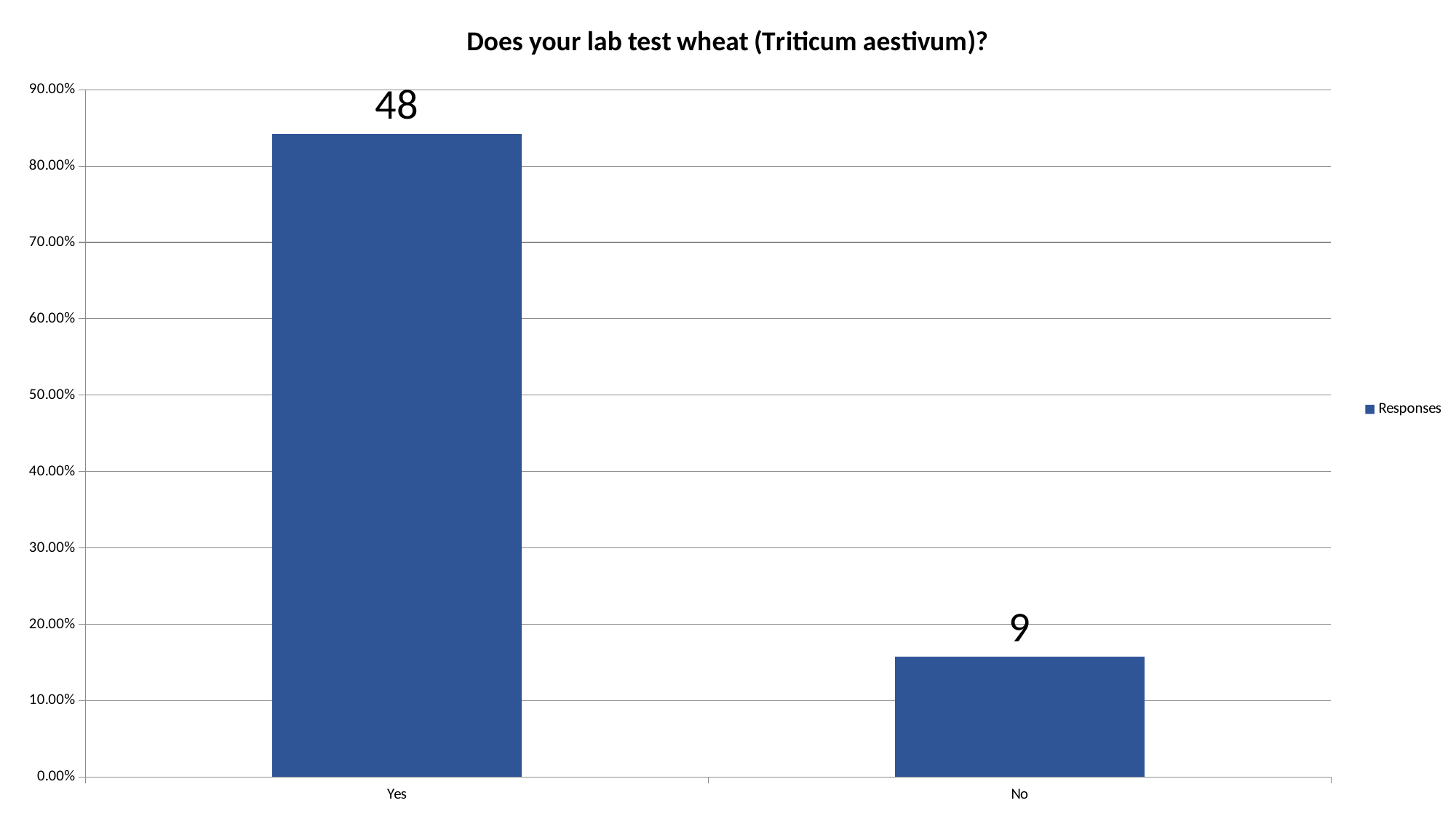
How many series does the legend list? 1 What kind of chart is this? Bar chart What is the data label shown on the Yes bar? 48 Is the percentage for No greater or less than 20.00%? less Which is larger, the value for Yes or the value for No? Yes What is the title of the chart? Does your lab test wheat (Triticum aestivum)? Which category has the highest value? Yes Is the percentage for Yes greater or less than 80.00%? greater Which category has the lowest value? No What is the data label shown on the No bar? 9 How many categories are shown on the x axis? 2 What is the difference between the data labels for Yes and No? 39